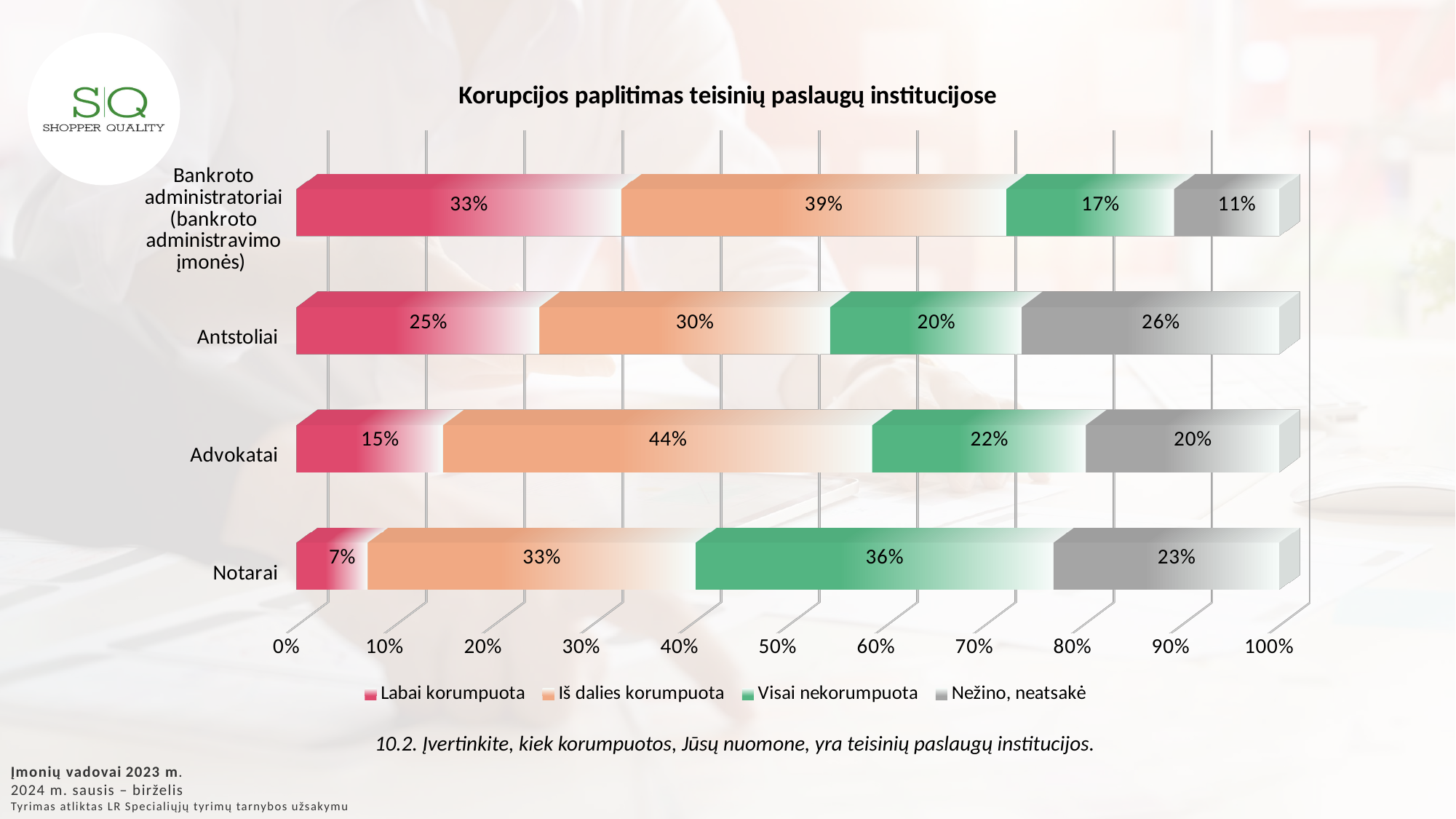
What is the 'Labai korumpuota' value for Notarai? 7% Which category has the highest 'Labai korumpuota' value? Bankroto administratoriai (bankroto administravimo įmonės) What is the 'Iš dalies korumpuota' value for Advokatai? 44% How many categories are shown on the chart? 4 What is the title of the chart? Korupcijos paplitimas teisinių paslaugų institucijose What is the difference between the 'Visai nekorumpuota' values for Notarai and Antstoliai? 16% What kind of chart is shown on the slide? Stacked bar chart How many series does the legend list? 4 Which is larger: the 'Iš dalies korumpuota' value for Antstoliai or for Notarai? Notarai Which category has the lowest 'Visai nekorumpuota' value? Bankroto administratoriai (bankroto administravimo įmonės) What is the 'Visai nekorumpuota' value for Bankroto administratoriai (bankroto administravimo įmonės)? 17% What is the 'Nežino, neatsakė' value for Antstoliai? 26%